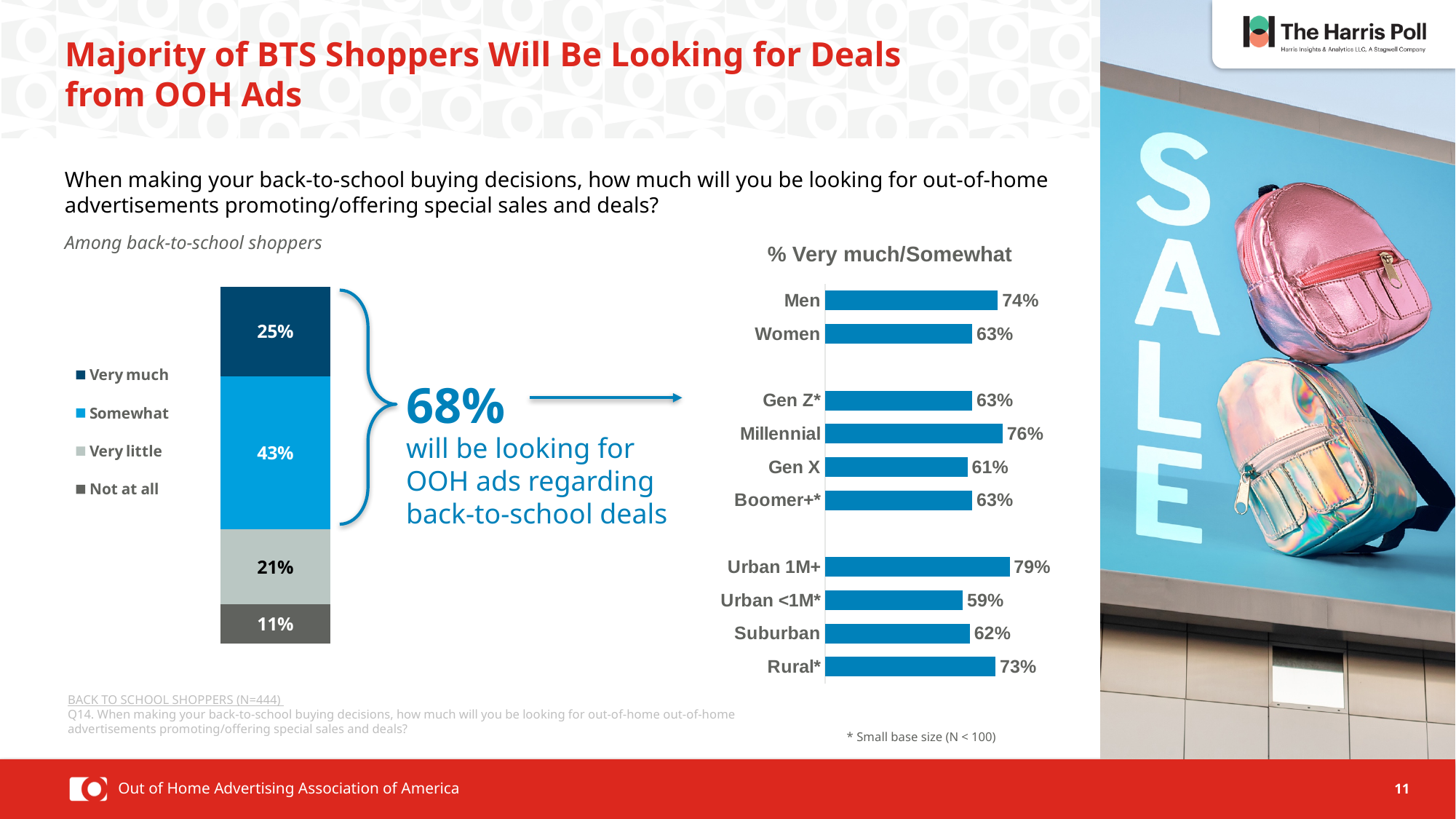
In the stacked bar chart on the left, what percentage of back-to-school shoppers answered "Very much"? 25% In the stacked bar chart on the left, what percentage answered "Not at all"? 11% In the "% Very much/Somewhat" chart, what is the difference between Men and Women? 11% In the "% Very much/Somewhat" chart, which is larger, Rural* or Gen X? Rural* In the stacked bar chart on the left, how many series does the legend list? 4 In the "% Very much/Somewhat" chart, what is the value for Suburban? 62% In the stacked bar chart on the left, what is the combined share of "Very much" and "Somewhat"? 68% In the "% Very much/Somewhat" chart, which category has the lowest value? Urban <1M* In the "% Very much/Somewhat" chart, what is the value for Millennial? 76% In the "% Very much/Somewhat" chart, which category has the highest value? Urban 1M+ In the stacked bar chart on the left, which response has the largest share? Somewhat In the "% Very much/Somewhat" chart, how many categories are shown? 10